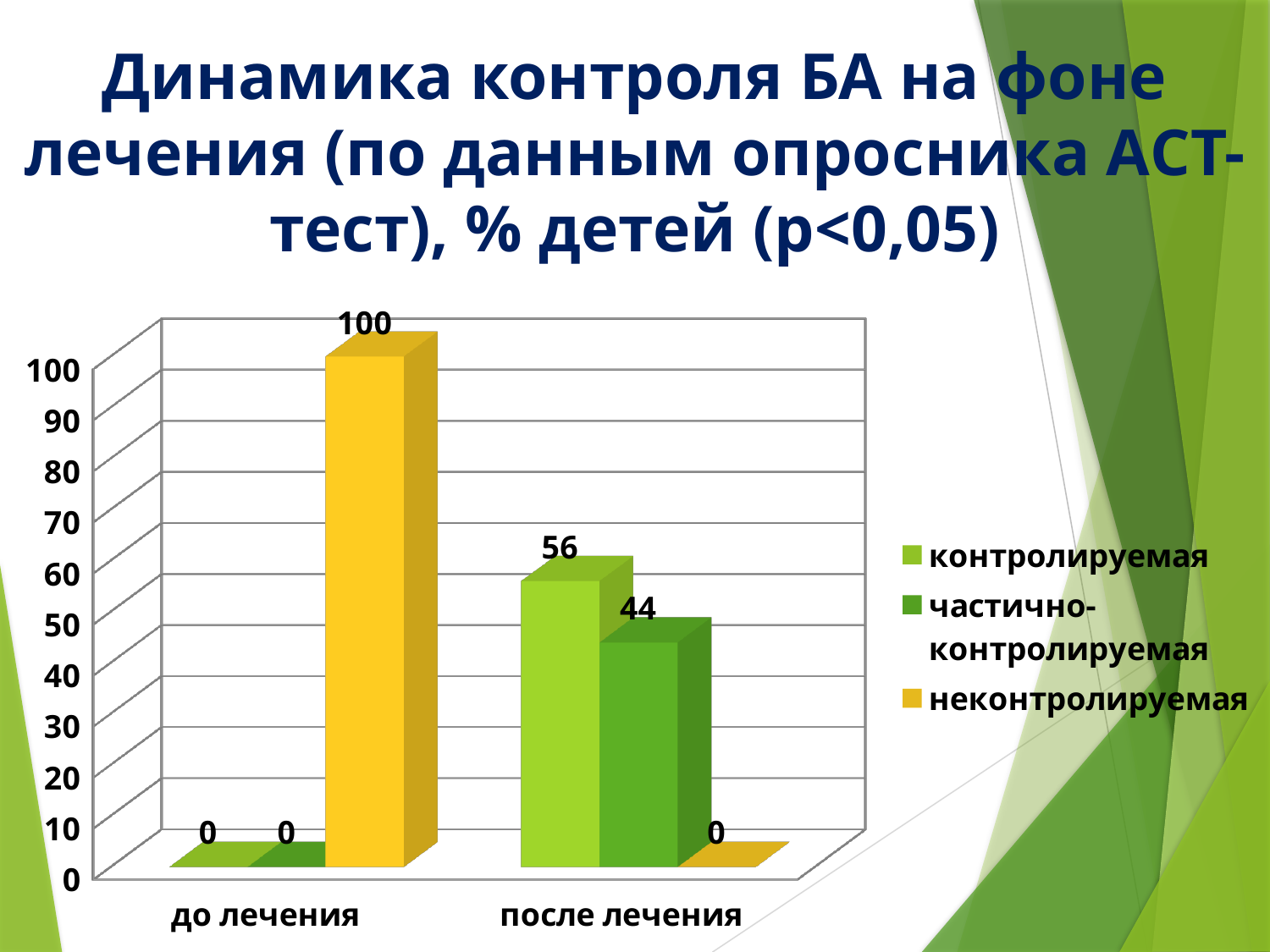
How many series does the legend list? 3 How many categories are shown on the x axis? 2 What is the difference between контролируемая and частично-контролируемая in the после лечения category? 12 What is the value for неконтролируемая in the после лечения category? 0 What is the value for контролируемая in the до лечения category? 0 Does the value for неконтролируемая rise or fall from до лечения to после лечения? fall What kind of chart is shown on the slide? bar chart What is the value for частично-контролируемая in the после лечения category? 44 Which is larger: неконтролируемая in до лечения or контролируемая in после лечения? неконтролируемая in до лечения What is the value for неконтролируемая in the до лечения category? 100 Which series has the highest value in the после лечения category? контролируемая What is the value for контролируемая in the после лечения category? 56